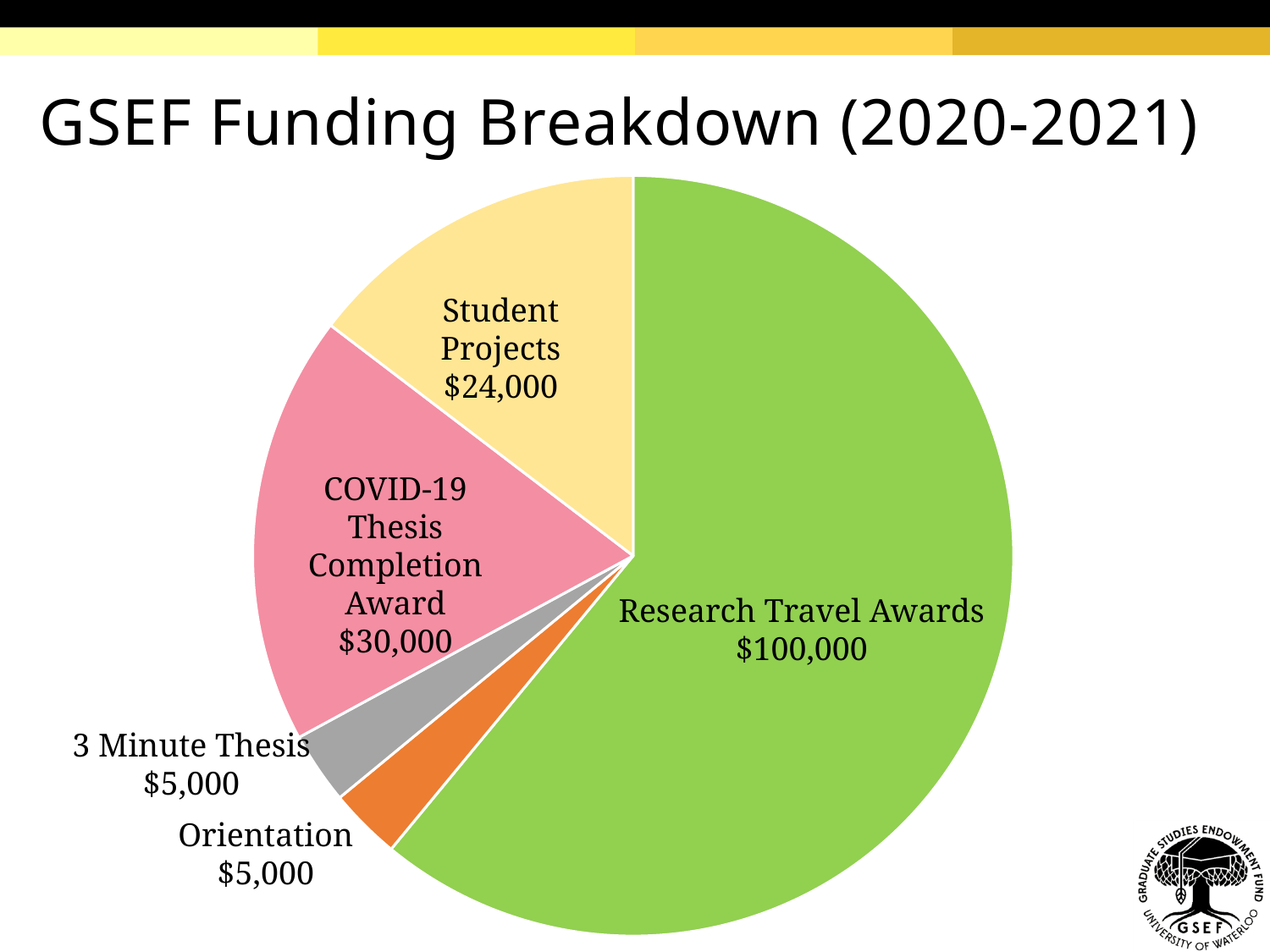
What is the total funding across all categories in the pie chart? $164,000 Which two categories are tied for the smallest amount of funding? 3 Minute Thesis and Orientation What is the value for Orientation? $5,000 What is the title of the chart? GSEF Funding Breakdown (2020-2021) Which category received the most funding? Research Travel Awards What kind of chart is shown on the slide? Pie chart Which is larger, Student Projects or the COVID-19 Thesis Completion Award? COVID-19 Thesis Completion Award What is the difference between Research Travel Awards and the COVID-19 Thesis Completion Award? $70,000 What is the value for the COVID-19 Thesis Completion Award? $30,000 How much funding went to Research Travel Awards? $100,000 How many categories does the pie chart show? 5 How much funding is shown for Student Projects? $24,000